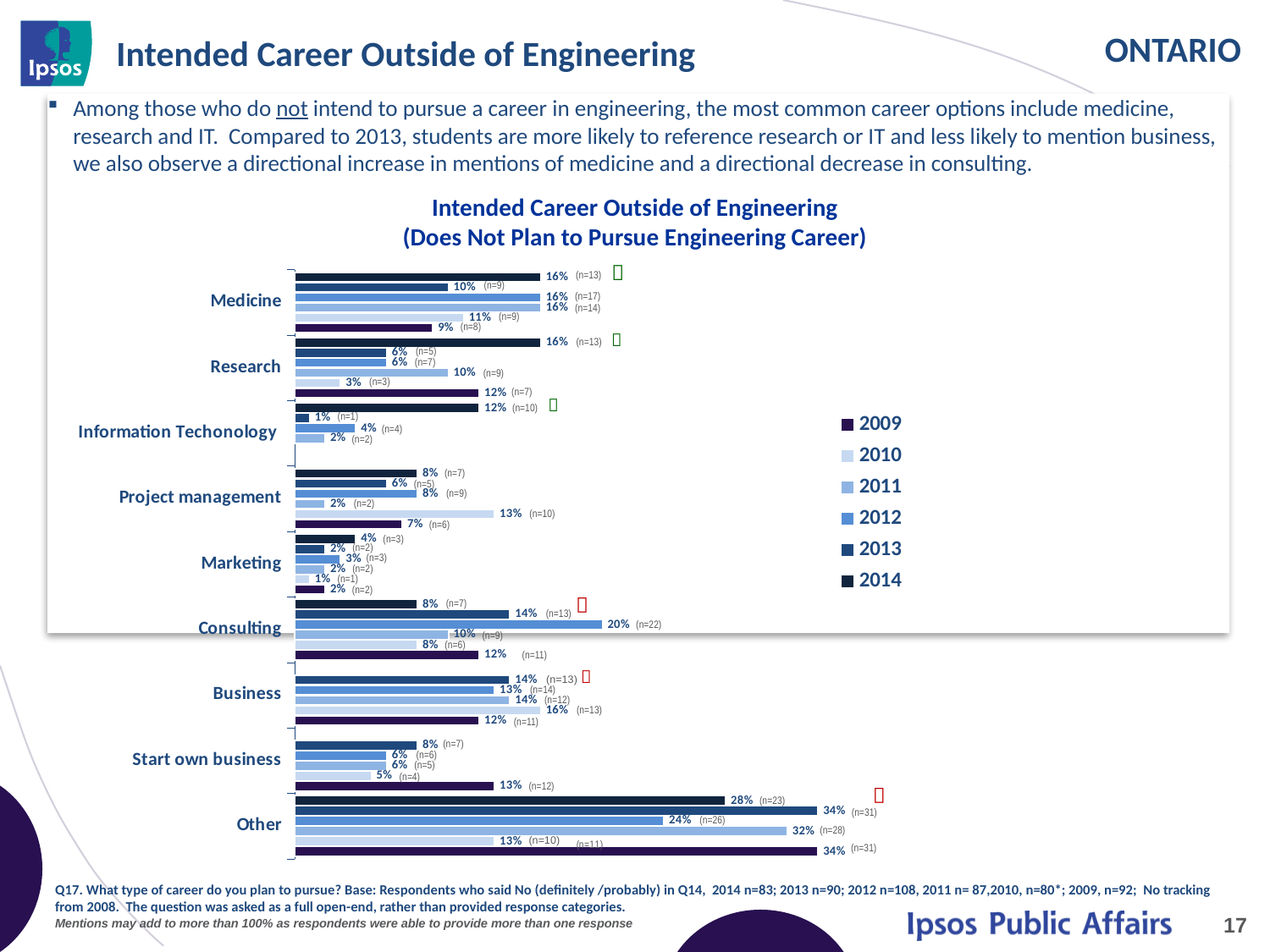
What is the 2014 value for Other? 28% What type of chart is shown on the slide? Bar chart What is the 2012 value for Consulting? 20% How many series does the legend list? 6 How many career categories are shown on the chart? 9 Which category has the lowest 2014 value? Marketing Which category has the highest 2014 value? Other What is the 2010 value for Project management? 13% What is the difference between the 2013 and 2014 values for Other? 6 percentage points What is the title of the chart? Intended Career Outside of Engineering (Does Not Plan to Pursue Engineering Career) Which is larger for Consulting: the 2012 value or the 2014 value? 2012 What is the 2014 value for Medicine? 16%